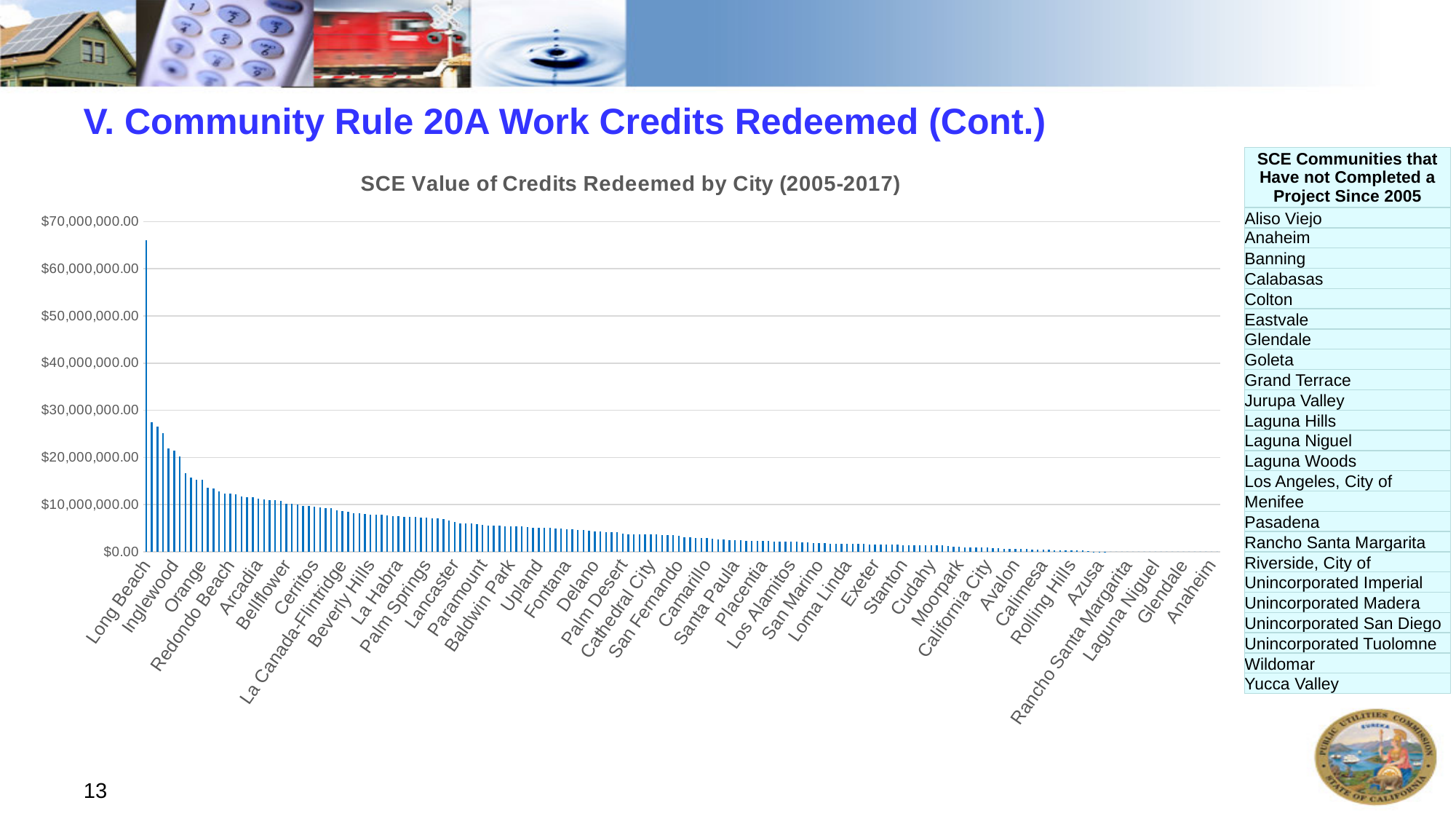
Which has a larger value of credits redeemed, Long Beach or Anaheim? Long Beach Is the value for Long Beach greater or less than $60,000,000.00? greater Is the value for Orange greater or less than $20,000,000.00? less What is the highest value shown on the y axis? $70,000,000.00 Is the value for Fontana greater or less than $10,000,000.00? less What is the title of the chart? SCE Value of Credits Redeemed by City (2005-2017) Do the bar values rise or fall moving from left to right along the x axis? fall What kind of chart is shown on the slide? bar chart Which has a larger value of credits redeemed, Orange or Upland? Orange Which city has the highest value of credits redeemed? Long Beach